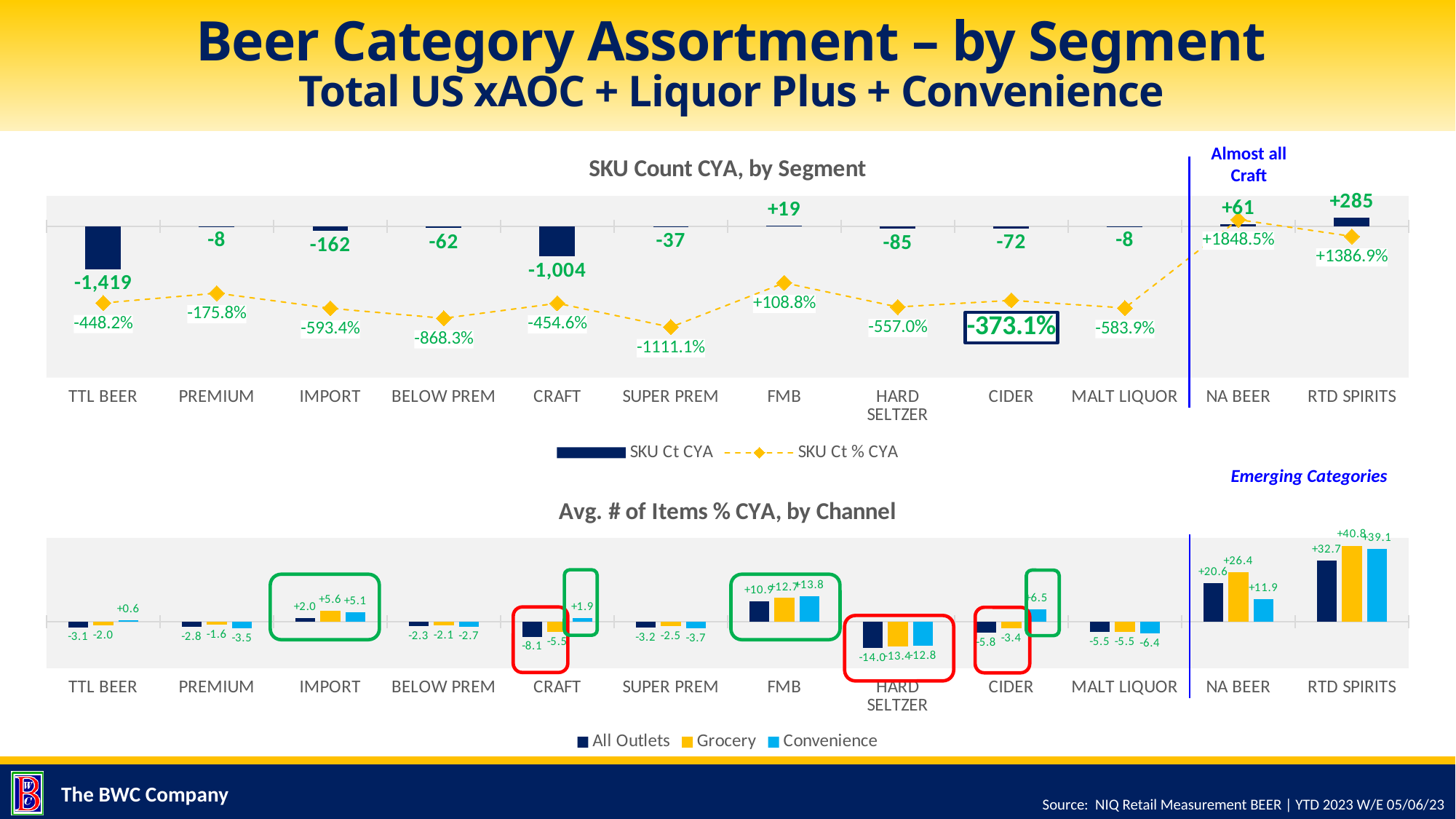
What type of chart is the 'Avg. # of Items % CYA, by Channel' chart? Bar chart In the 'Avg. # of Items % CYA, by Channel' chart, what is the Grocery value for NA BEER? +26.4 In the 'SKU Count CYA, by Segment' chart, what is the SKU Ct % CYA value for SUPER PREM? -1111.1% In the 'Avg. # of Items % CYA, by Channel' chart, which is larger for CIDER: the Grocery value or the Convenience value? Convenience In the 'SKU Count CYA, by Segment' chart, which segment has the lowest SKU Ct CYA value? TTL BEER In the 'SKU Count CYA, by Segment' chart, how many series does the legend list? 2 In the 'SKU Count CYA, by Segment' chart, what is the difference between the SKU Ct CYA values for RTD SPIRITS and NA BEER? 224 In the 'Avg. # of Items % CYA, by Channel' chart, how many segments are shown on the x axis? 12 In the 'Avg. # of Items % CYA, by Channel' chart, what is the All Outlets value for HARD SELTZER? -14.0 In the 'SKU Count CYA, by Segment' chart, which segment has the highest SKU Ct CYA value? RTD SPIRITS In the 'Avg. # of Items % CYA, by Channel' chart, how many series does the legend list? 3 In the 'SKU Count CYA, by Segment' chart, what is the SKU Ct CYA value for CRAFT? -1,004